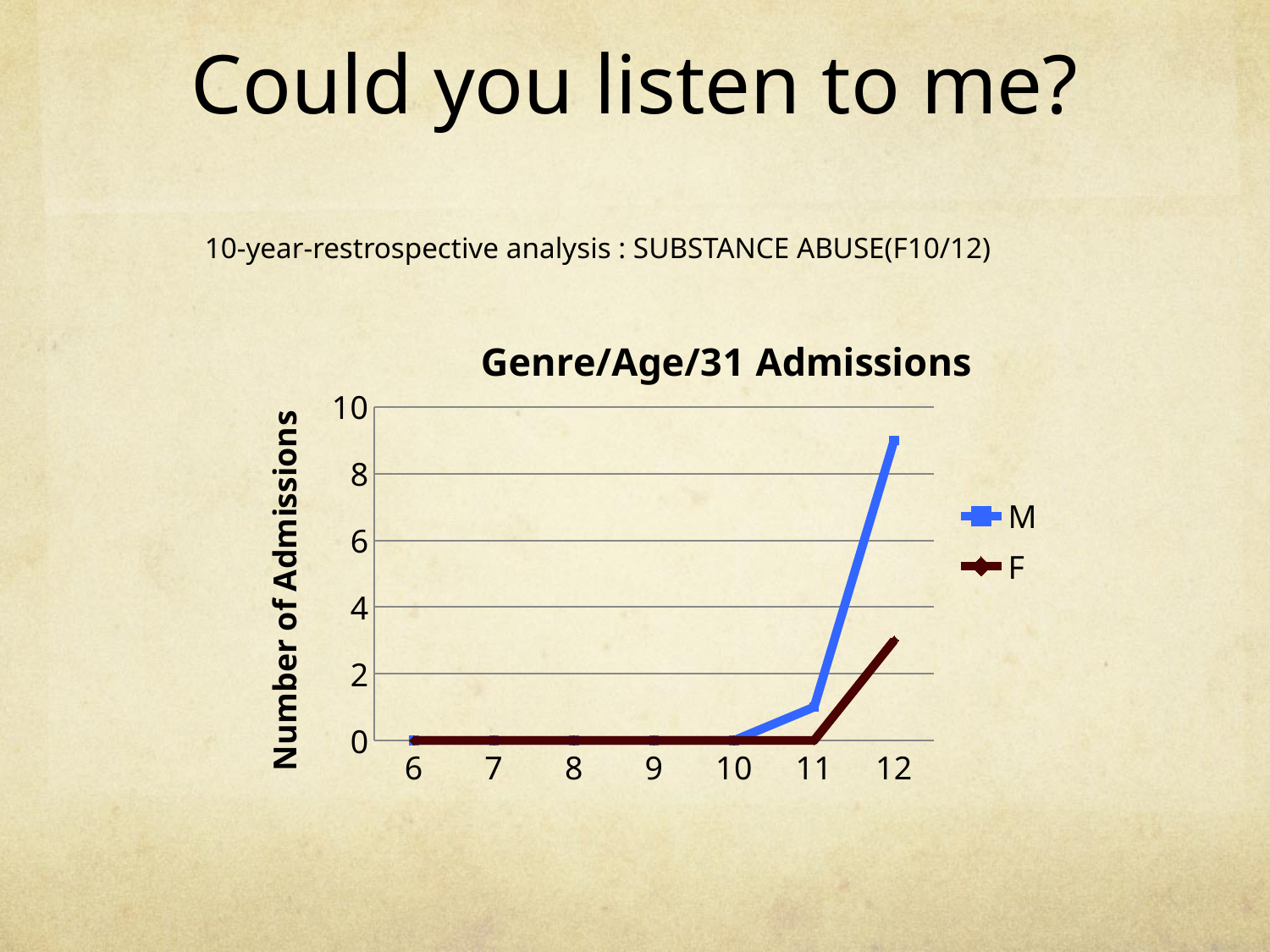
What is the value of the M series at age 10? 0 Is the value for F at age 12 greater or less than 4? less At age 12, which series has the larger value, M or F? M Does the M series rise or fall from age 10 to age 12? rise What kind of chart is shown on the slide? line chart What is the label of the vertical axis? Number of Admissions How many age categories are shown on the x axis? 7 At which age does the M series reach its highest value? 12 How many series does the legend list? 2 What is the value of the F series at age 11? 0 Is the value for M at age 12 greater or less than 8? greater What is the title of the chart? Genre/Age/31 Admissions